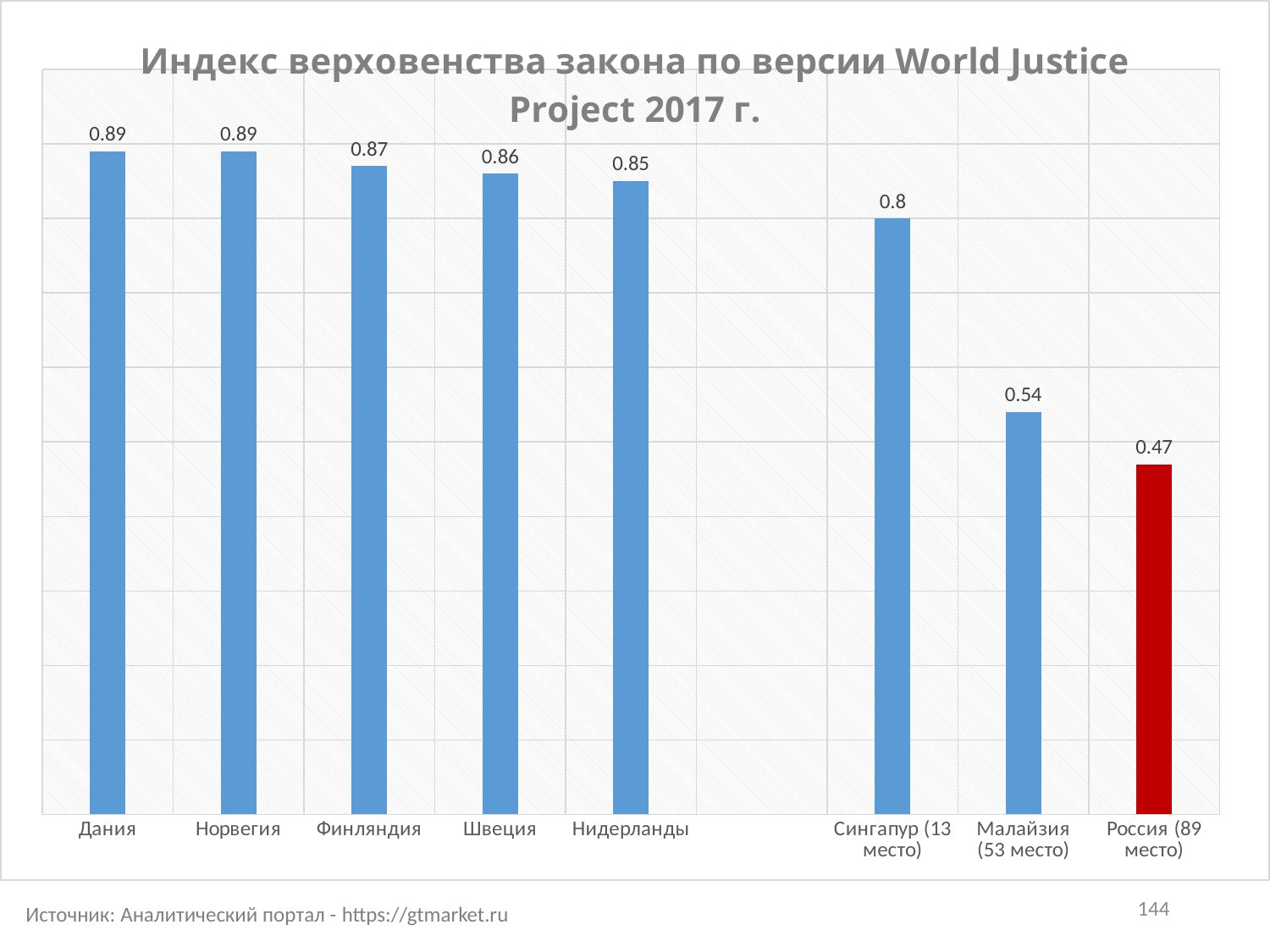
What is the value for Финляндия? 0.87 What kind of chart is shown on the slide? Bar chart What is the difference between the values for Дания and Россия (89 место)? 0.42 How many bars are plotted in the chart? 8 What is the value for Сингапур (13 место)? 0.8 Which category has the lowest value? Россия (89 место) Do the values rise or fall from left to right along the x axis? Fall Which bar is coloured red instead of blue? Россия (89 место) What is the difference between the values for Сингапур (13 место) and Малайзия (53 место)? 0.26 What is the value for Россия (89 место)? 0.47 What is the value for Малайзия (53 место)? 0.54 Which is larger, the value for Швеция or the value for Нидерланды? Швеция